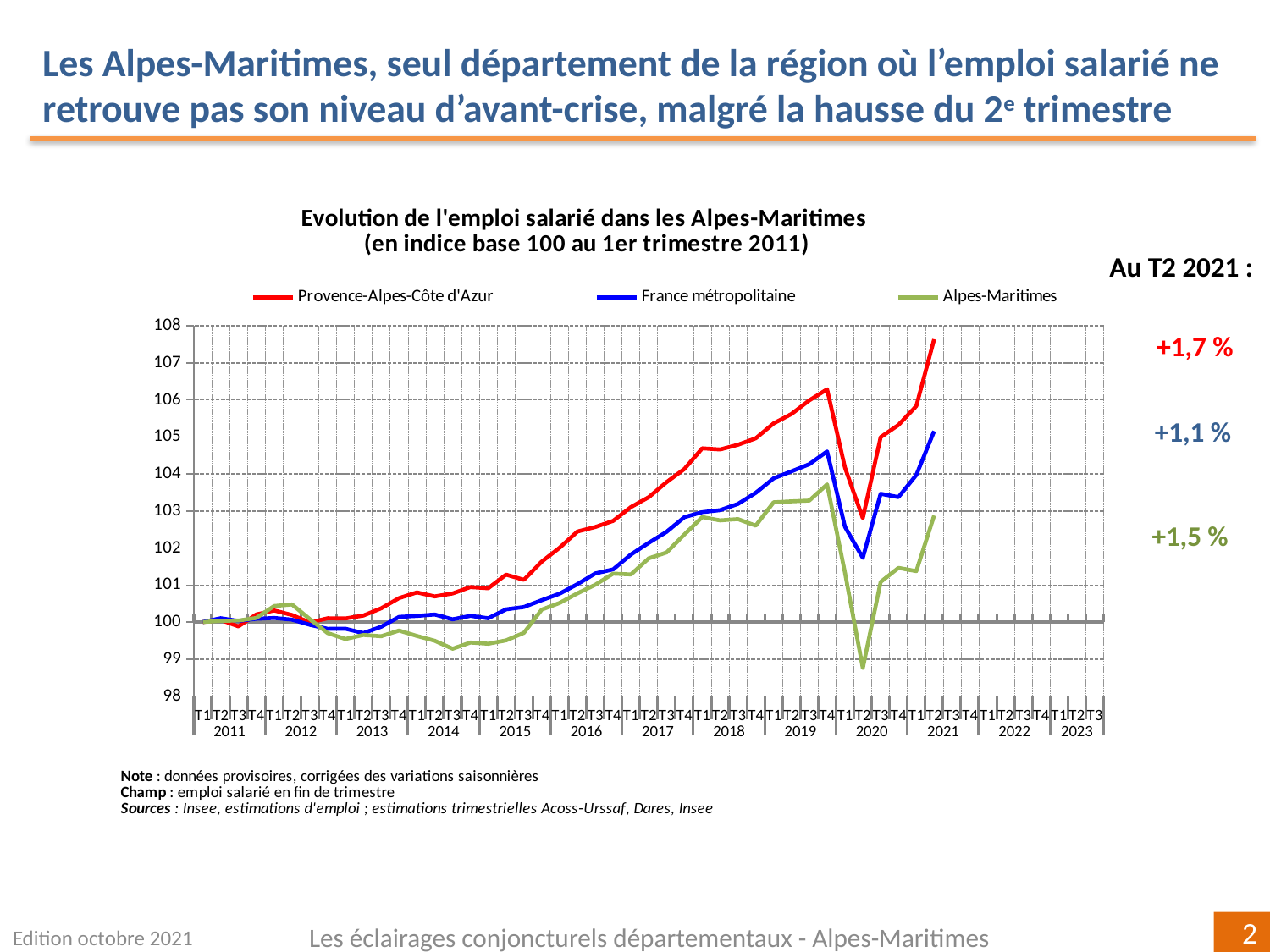
What quarterly change is shown for Alpes-Maritimes at T2 2021? +1,5 % Which series has the highest index value at T2 2021? Provence-Alpes-Côte d'Azur What kind of chart is shown on the slide? line chart Between 2015 and 2019, does the Provence-Alpes-Côte d'Azur series rise or fall? rise What quarterly change is shown for France métropolitaine at T2 2021? +1,1 % Is the value for Alpes-Maritimes at T2 2020 greater or less than 100? less Which series has the lowest index value at T2 2020? Alpes-Maritimes Which series is plotted in red? Provence-Alpes-Côte d'Azur What quarterly change is shown for Provence-Alpes-Côte d'Azur at T2 2021? +1,7 % What is the base period of the index used in the chart? 1er trimestre 2011 (base 100) Is the value for Provence-Alpes-Côte d'Azur at T2 2021 greater or less than 107? greater How many series does the legend list? 3